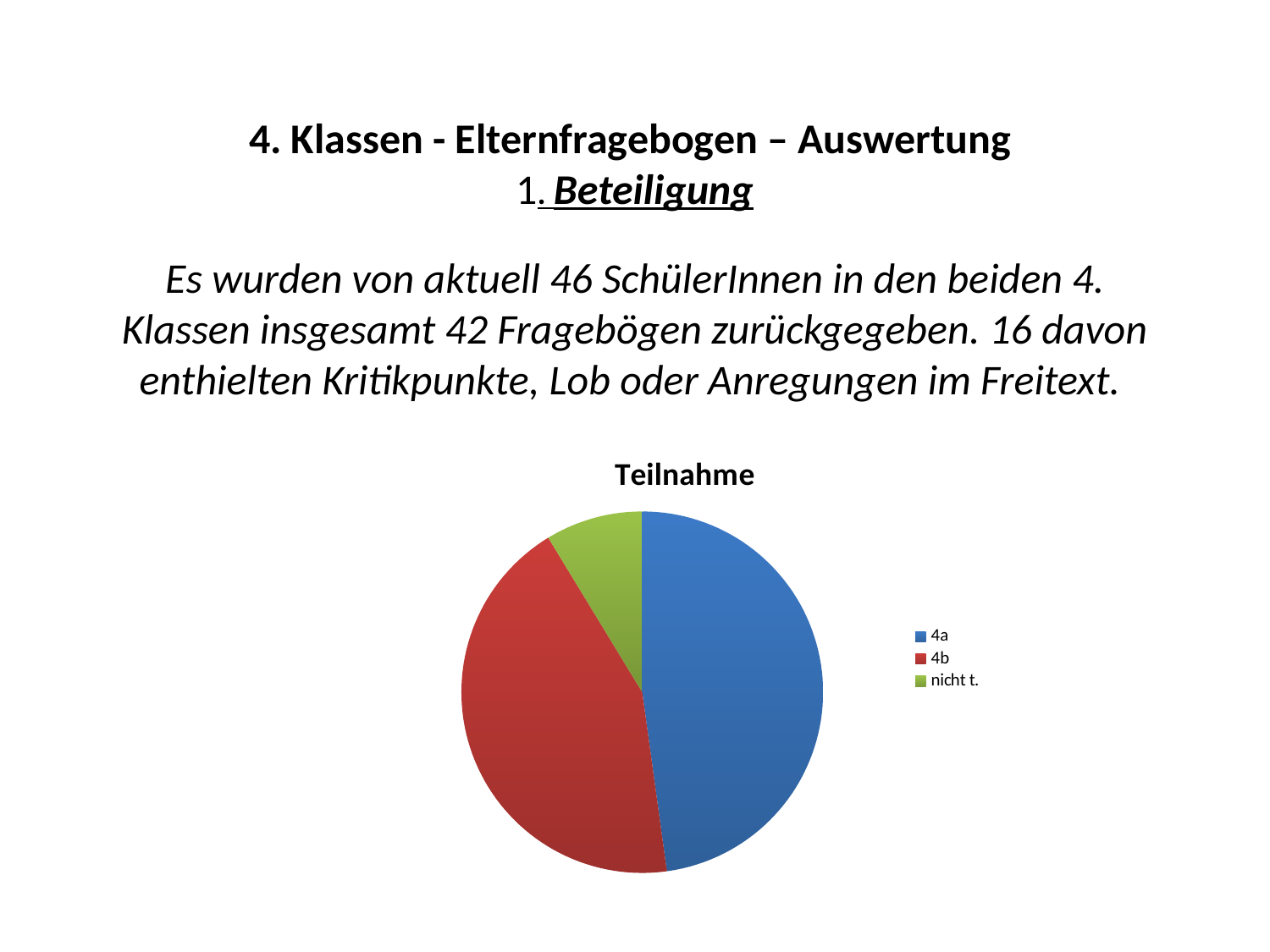
Which category has the largest slice in the pie chart? 4a What is the title of the chart? Teilnahme Which slice is larger, 4a or 4b? 4a What kind of chart is shown on the slide? pie chart Which slice is larger, 4b or nicht t.? 4b What colour is the slice for 4b in the pie chart? red Which slice is larger, 4a or nicht t.? 4a How many entries does the legend of the pie chart list? 3 How many slices does the pie chart have? 3 Which category has the smallest slice in the pie chart? nicht t.